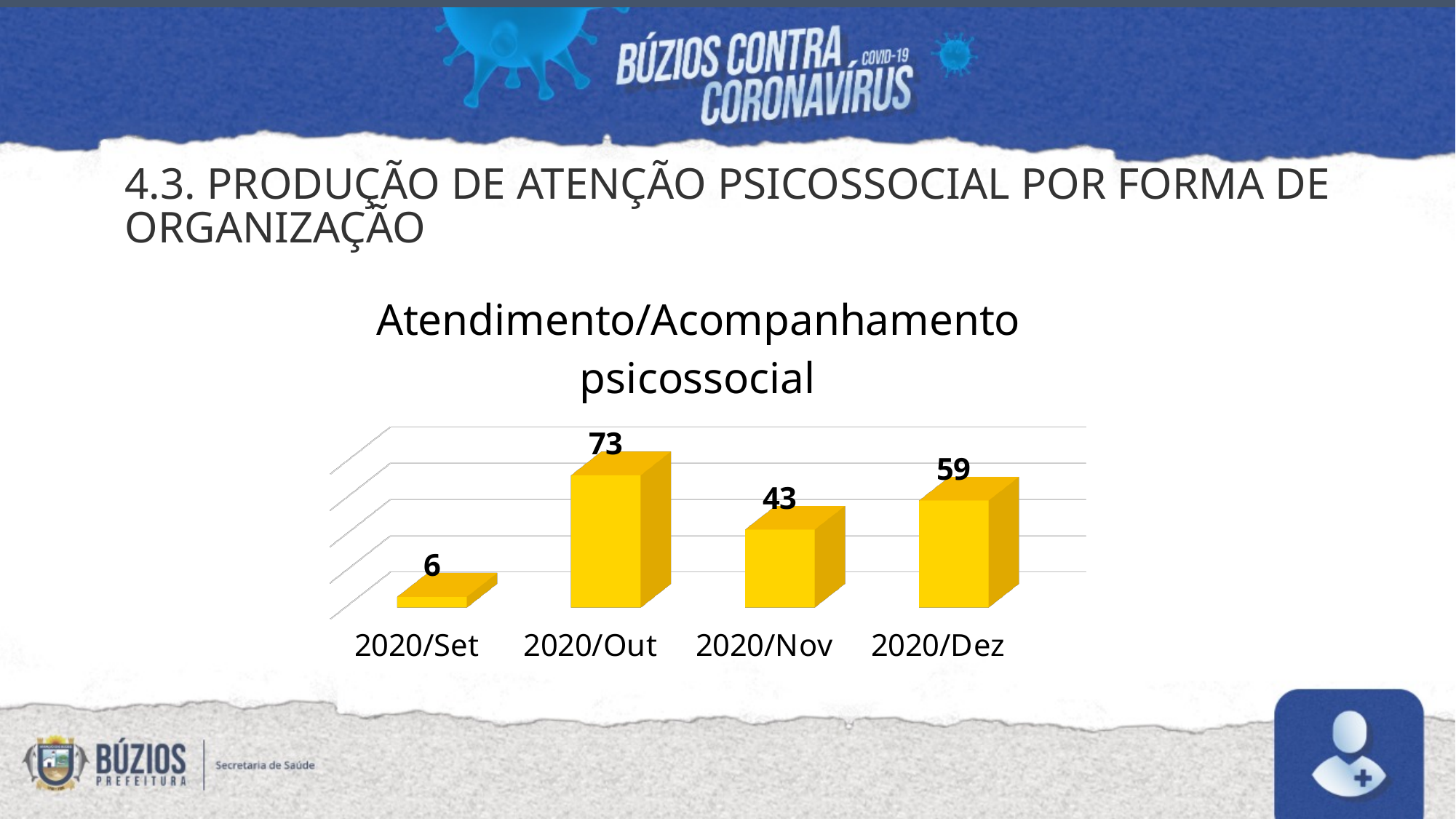
What is the title of the chart? Atendimento/Acompanhamento psicossocial Which is larger, the value for 2020/Nov or the value for 2020/Dez? 2020/Dez What is the difference between the values for 2020/Dez and 2020/Set? 53 What kind of chart is shown on the slide? bar chart What is the value for 2020/Nov? 43 Which month has the lowest value? 2020/Set What is the value for 2020/Out? 73 What is the value for 2020/Dez? 59 How many months are shown on the x axis? 4 What is the value for 2020/Set? 6 Which month has the highest value? 2020/Out What is the difference between the values for 2020/Out and 2020/Nov? 30